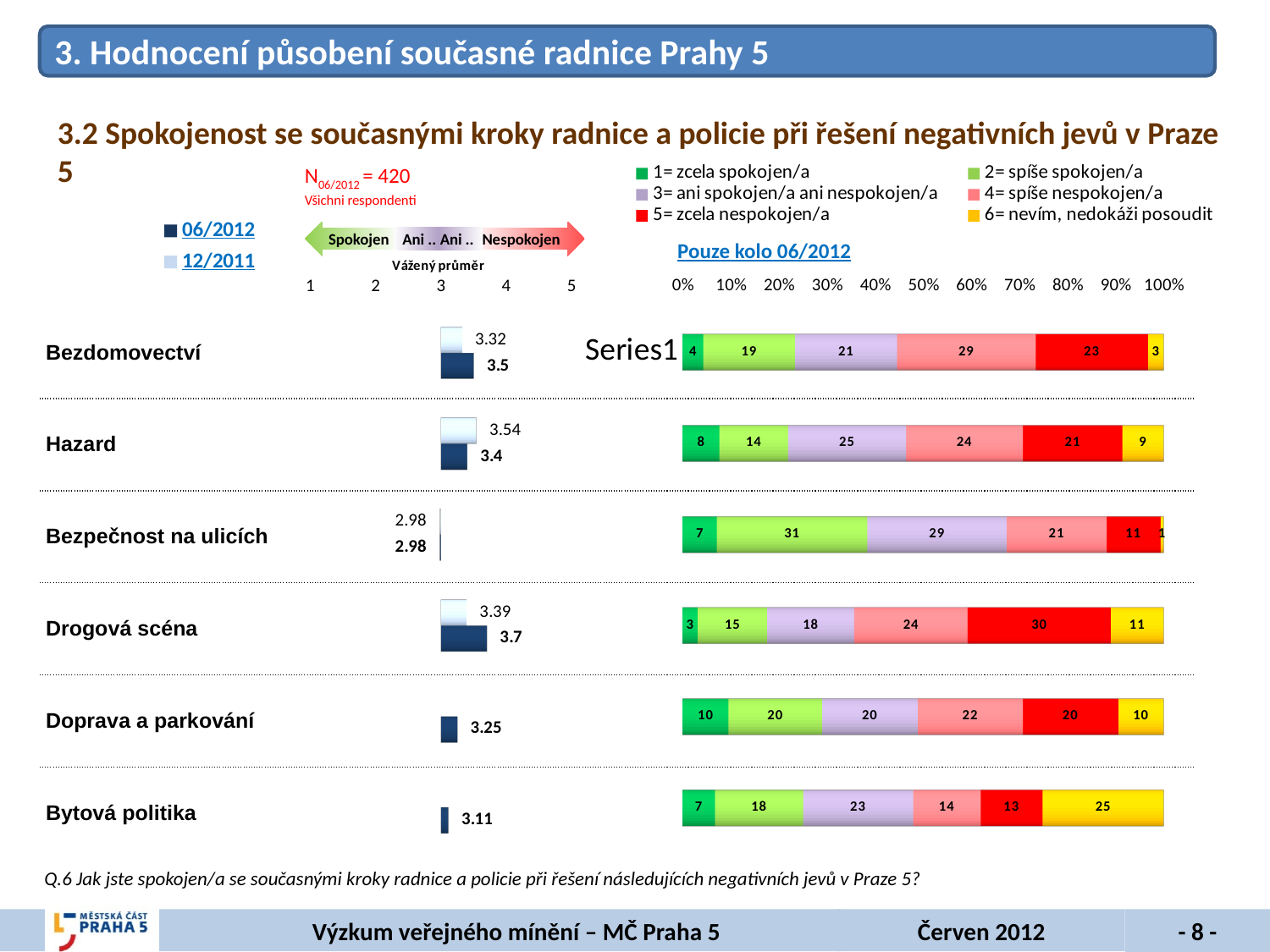
In the weighted average chart (Vážený průměr), what is the 06/2012 value for Drogová scéna? 3.7 In the stacked bar chart (Pouze kolo 06/2012), what is the value for '5= zcela nespokojen/a' for Drogová scéna? 30 What type of chart is the chart on the right (Pouze kolo 06/2012)? Stacked bar chart In the stacked bar chart (Pouze kolo 06/2012), which category has the lowest value for '5= zcela nespokojen/a'? Bezpečnost na ulicích In the stacked bar chart (Pouze kolo 06/2012), which category has the highest value for '1= zcela spokojen/a'? Doprava a parkování In the stacked bar chart (Pouze kolo 06/2012), how many categories are shown? 6 In the stacked bar chart (Pouze kolo 06/2012), what is the value for '2= spíše spokojen/a' for Bezpečnost na ulicích? 31 In the stacked bar chart (Pouze kolo 06/2012), how many series does the legend list? 6 In the stacked bar chart (Pouze kolo 06/2012), what is the difference between the '4= spíše nespokojen/a' values for Bezdomovectví and Bytová politika? 15 In the weighted average chart (Vážený průměr), which is larger for Bezdomovectví: the 06/2012 value or the 12/2011 value? 06/2012 In the weighted average chart (Vážený průměr), what is the 12/2011 value for Hazard? 3.54 In the stacked bar chart (Pouze kolo 06/2012), what is the value for '6= nevím, nedokáži posoudit' for Bytová politika? 25